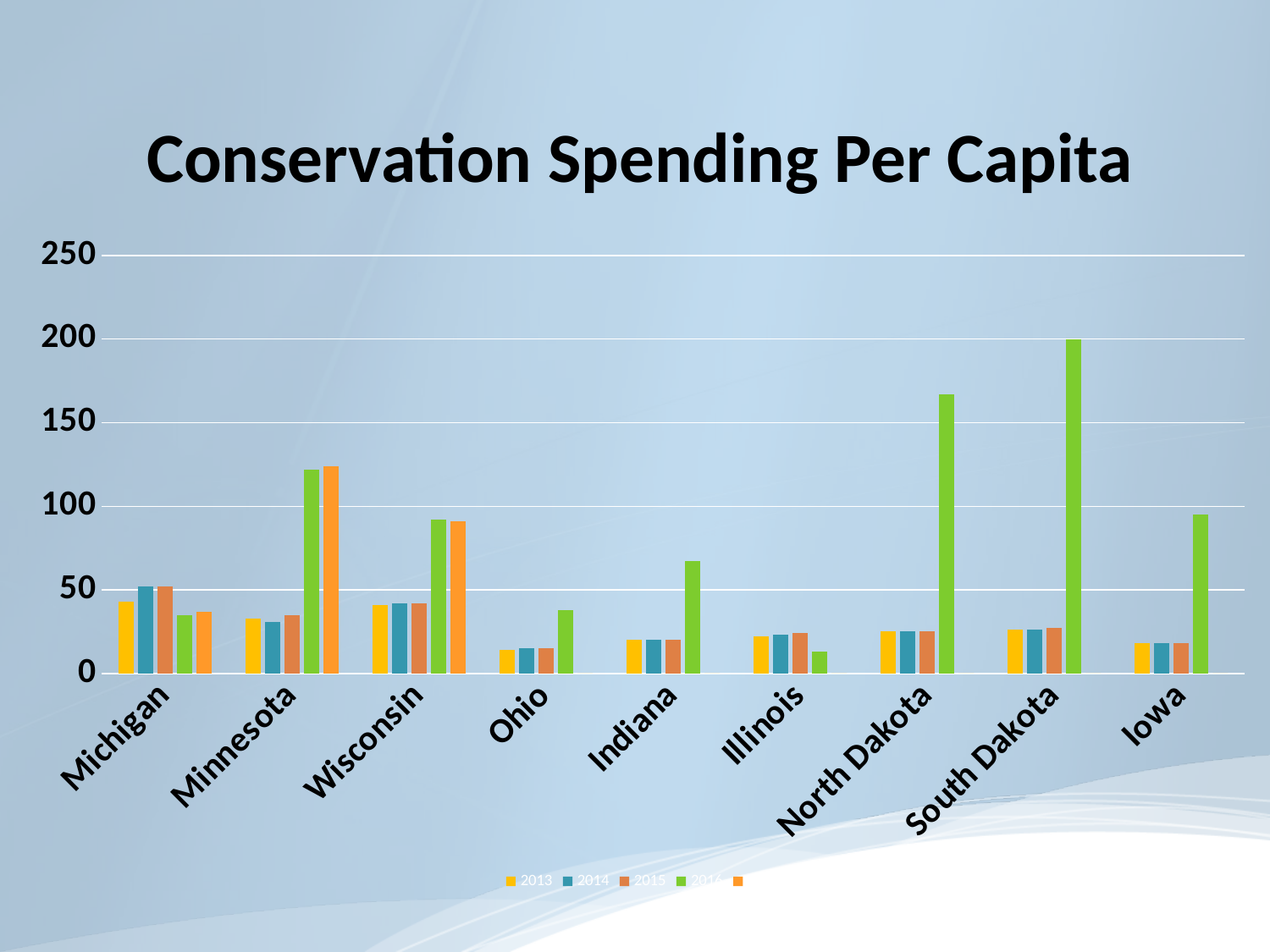
Which is larger for Michigan, the 2014 value or the 2016 value? 2014 Which state has the lowest 2016 value in the chart? Illinois Which state has the highest 2016 value in the chart? South Dakota Which is larger, the 2016 value for Indiana or the 2016 value for Ohio? Indiana What is the title of the chart? Conservation Spending Per Capita How many states are shown on the x axis of the chart? 9 Is the 2013 value for Michigan greater or less than 50? less What kind of chart is shown on the slide? Bar chart Is the 2016 value for Minnesota greater or less than 100? greater Which years are labelled in the chart's legend? 2013, 2014, 2015, 2016 Is the 2016 value for Ohio greater or less than 50? less